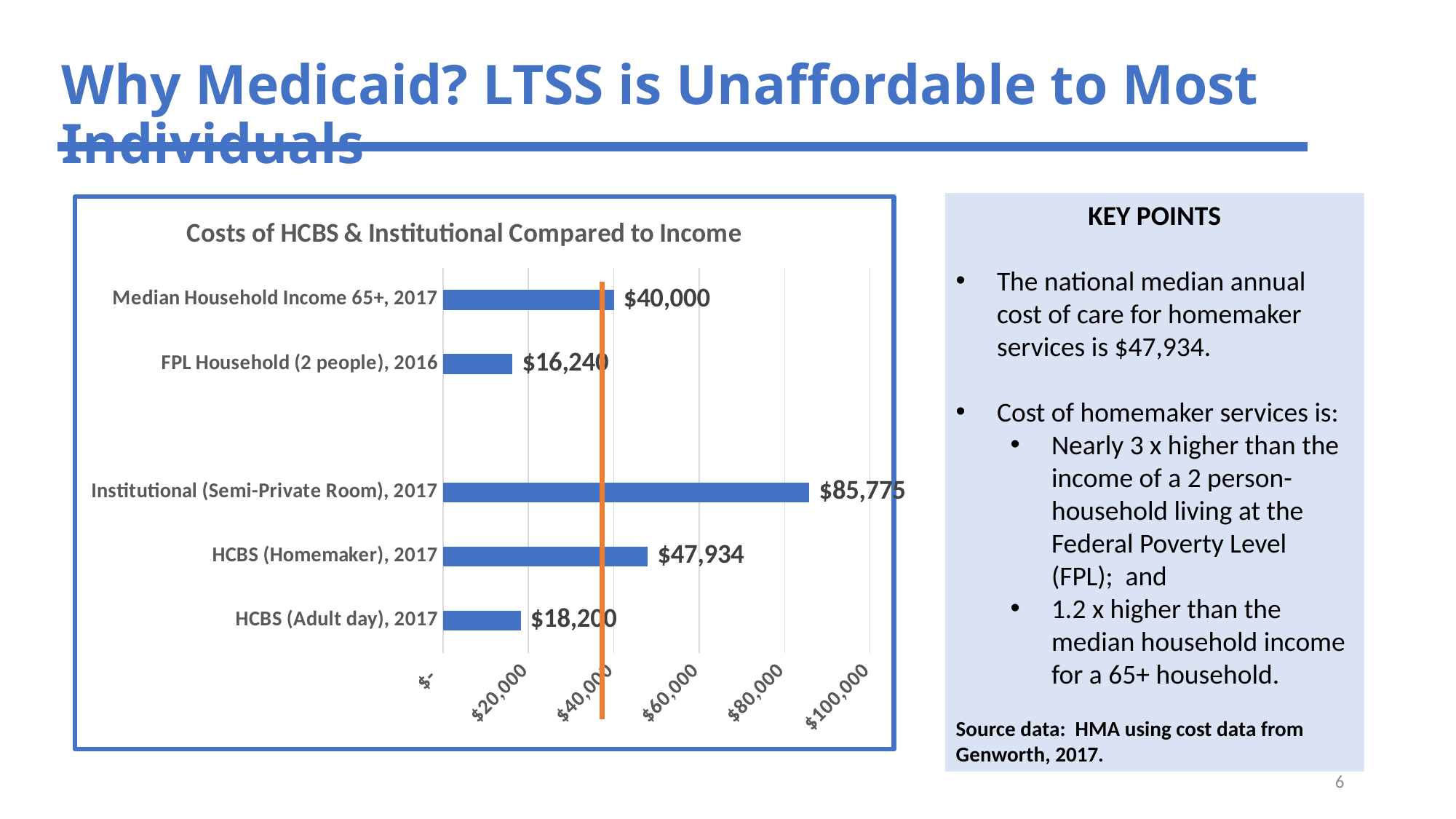
What is the value for HCBS (Homemaker), 2017? $47,934 What is the difference between Institutional (Semi-Private Room), 2017 and HCBS (Homemaker), 2017? $37,841 Which is larger, HCBS (Adult day), 2017 or FPL Household (2 people), 2016? HCBS (Adult day), 2017 What is the value for Institutional (Semi-Private Room), 2017? $85,775 Which category has the lowest value? FPL Household (2 people), 2016 Is the value for Institutional (Semi-Private Room), 2017 greater or less than $80,000? greater How many categories are shown in the chart? 5 What is the title of the chart? Costs of HCBS & Institutional Compared to Income Which category has the highest value? Institutional (Semi-Private Room), 2017 What is the difference between HCBS (Homemaker), 2017 and Median Household Income 65+, 2017? $7,934 What is the value for FPL Household (2 people), 2016? $16,240 What is the value for Median Household Income 65+, 2017? $40,000